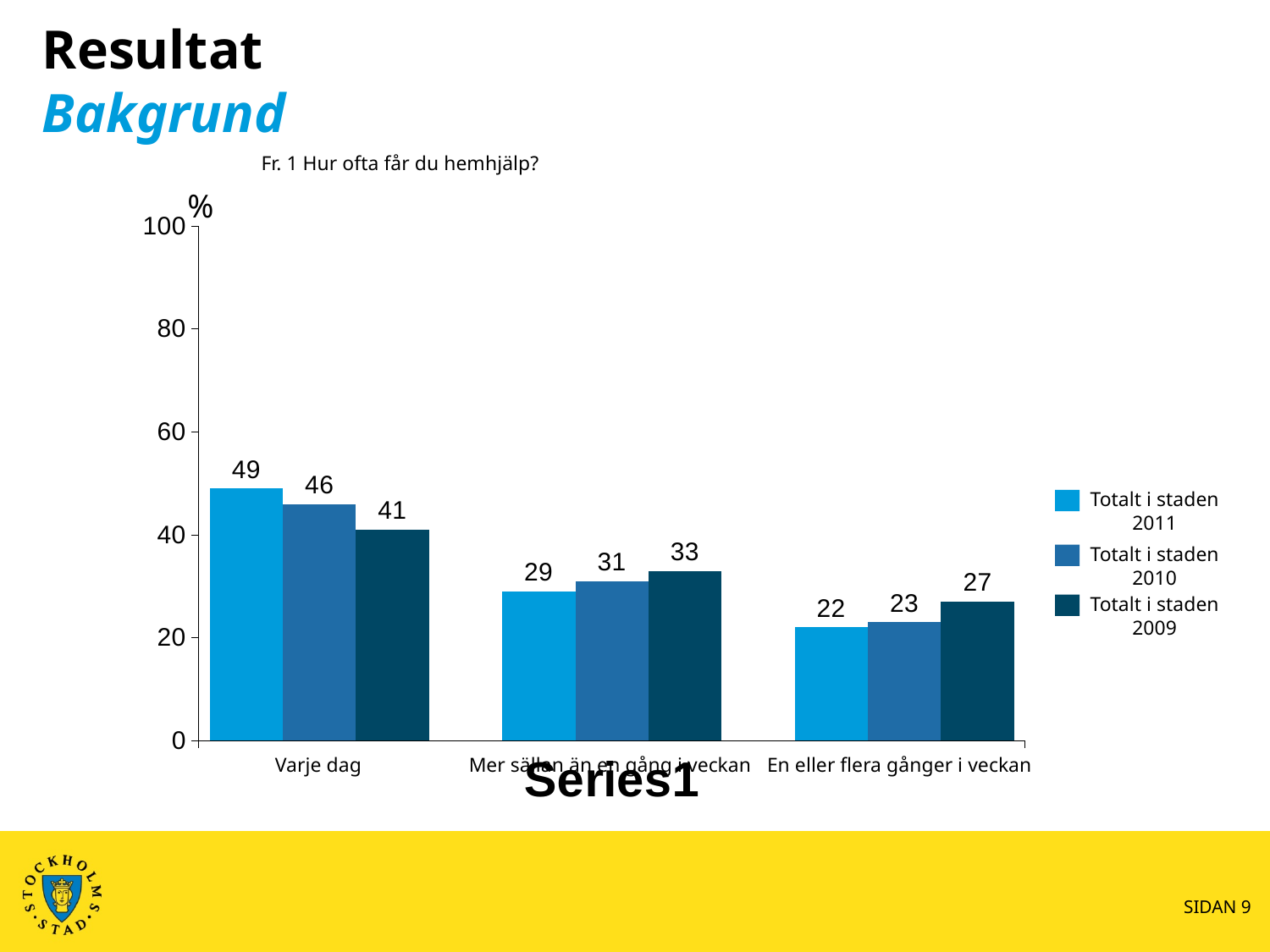
Which category has the lowest value for Totalt i staden 2009? En eller flera gånger i veckan Is the value for Totalt i staden 2010 in the Varje dag category greater or less than 40? greater What question is shown as the chart title? Fr. 1 Hur ofta får du hemhjälp? What is the value for Totalt i staden 2010 in the En eller flera gånger i veckan category? 23 What is the value for Totalt i staden 2009 in the Mer sällan än en gång i veckan category? 33 What is the value for Totalt i staden 2011 in the Varje dag category? 49 In the Mer sällan än en gång i veckan category, which is larger: Totalt i staden 2011 or Totalt i staden 2009? Totalt i staden 2009 How many series does the legend list? 3 What kind of chart is shown on the slide? bar chart How many categories are shown on the x axis? 3 What is the difference between the Totalt i staden 2011 and Totalt i staden 2009 values in the Varje dag category? 8 Which category has the highest value for Totalt i staden 2011? Varje dag